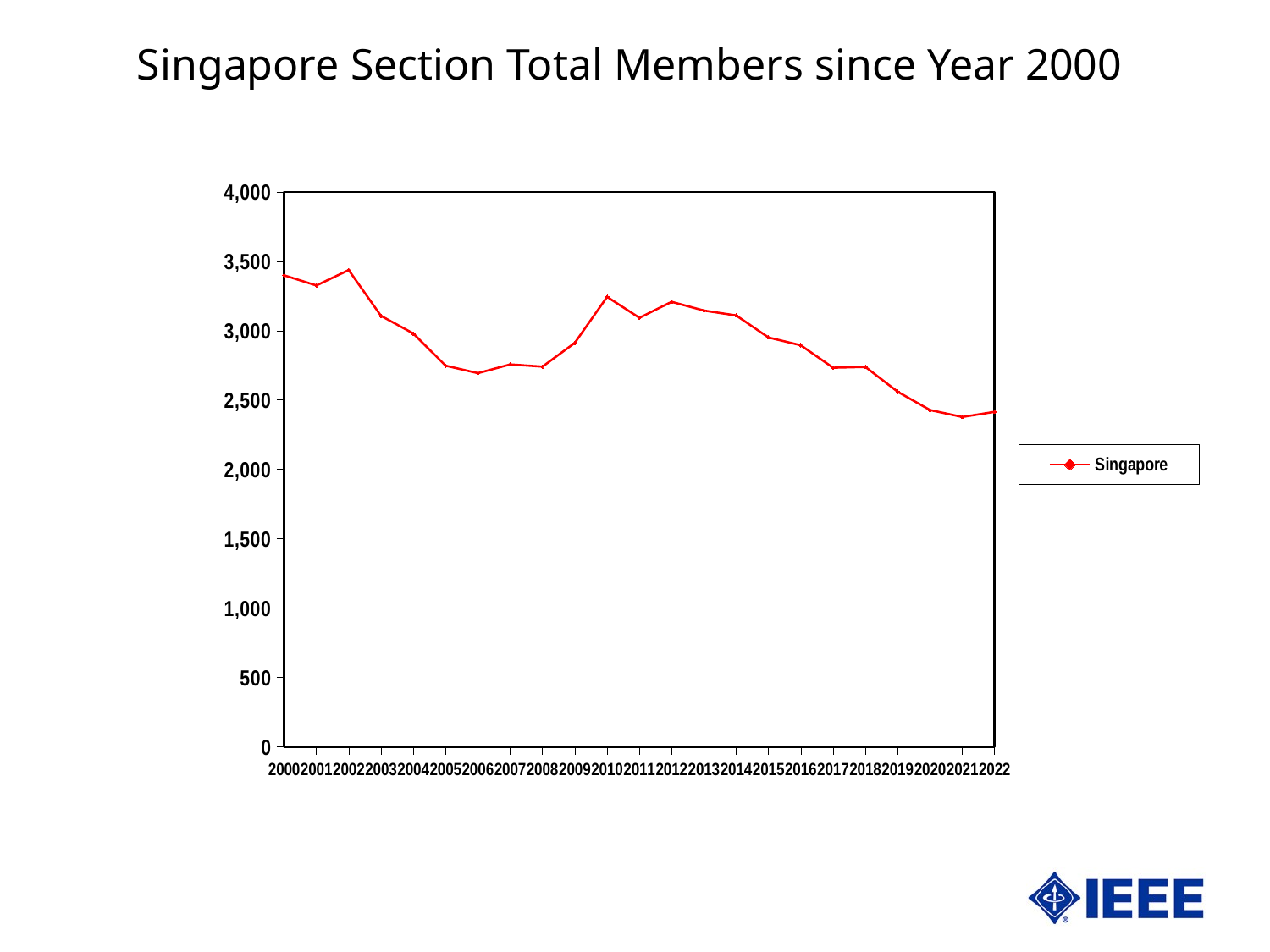
How many years are plotted along the x axis? 23 Is the value for 2021 greater or less than 2,500? less Which year has the larger value, 2002 or 2021? 2002 What kind of chart is shown on the slide? line chart Is the value for 2010 greater or less than 3,000? greater What is the title of the chart? Singapore Section Total Members since Year 2000 Is the value for 2005 greater or less than 3,000? less How many series does the legend list? 1 Which year has the larger value, 2006 or 2010? 2010 What is the name of the series shown in the legend? Singapore Do the values generally rise or fall from 2012 to 2021? fall